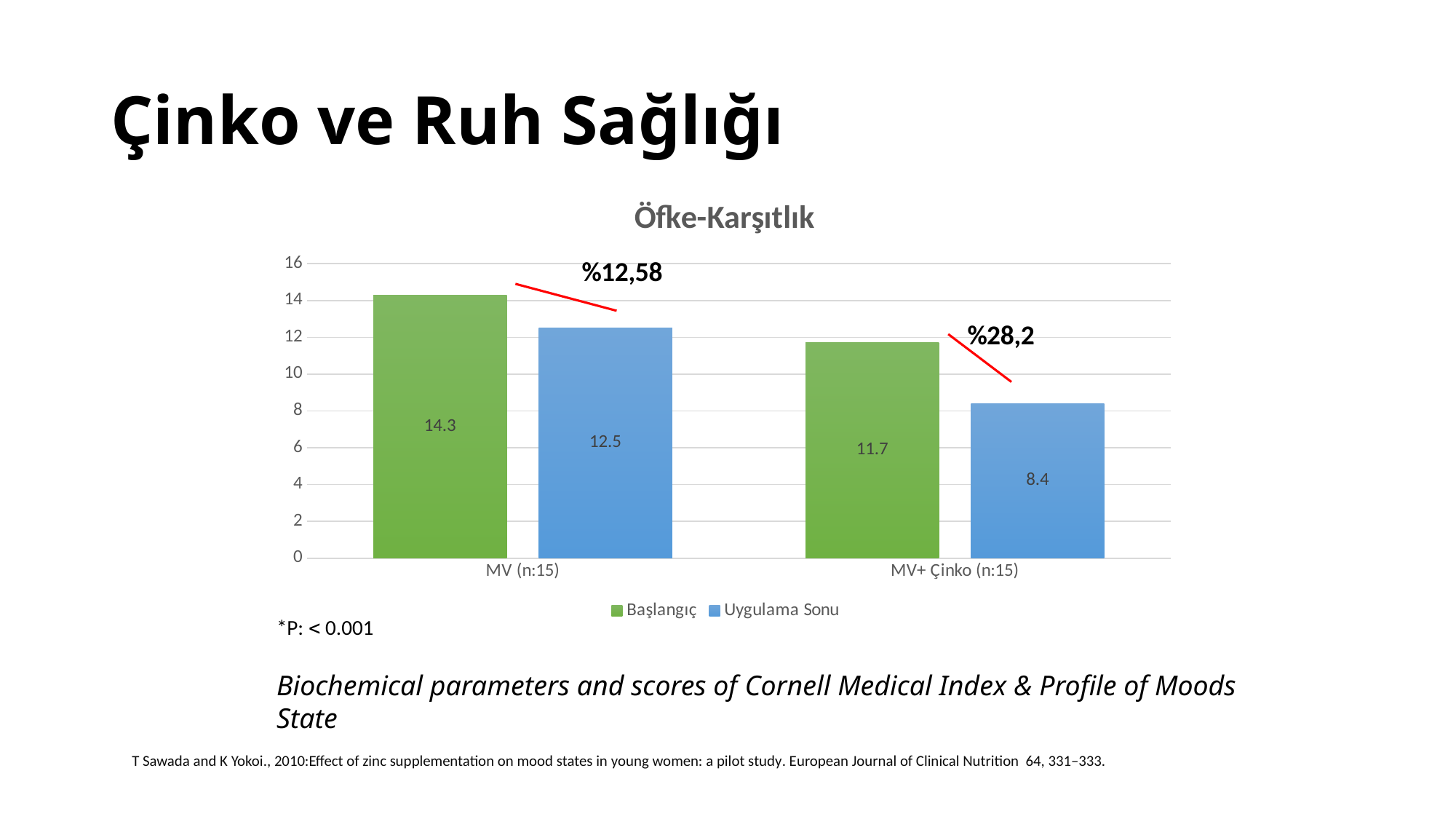
What is the Uygulama Sonu value for MV+ Çinko (n:15)? 8.4 Which is larger: the Uygulama Sonu value for MV (n:15) or the Başlangıç value for MV+ Çinko (n:15)? Uygulama Sonu for MV (n:15) How many categories are shown on the x axis? 2 What is the Başlangıç value for MV+ Çinko (n:15)? 11.7 Which bar has the highest value in the chart? Başlangıç for MV (n:15) What is the difference between the Başlangıç and Uygulama Sonu values for MV+ Çinko (n:15)? 3.3 What is the title of the chart? Öfke-Karşıtlık What is the Uygulama Sonu value for MV (n:15)? 12.5 Which bar has the lowest value in the chart? Uygulama Sonu for MV+ Çinko (n:15) What is the Başlangıç value for MV (n:15)? 14.3 How many series does the legend list? 2 What kind of chart is shown on the slide? Bar chart